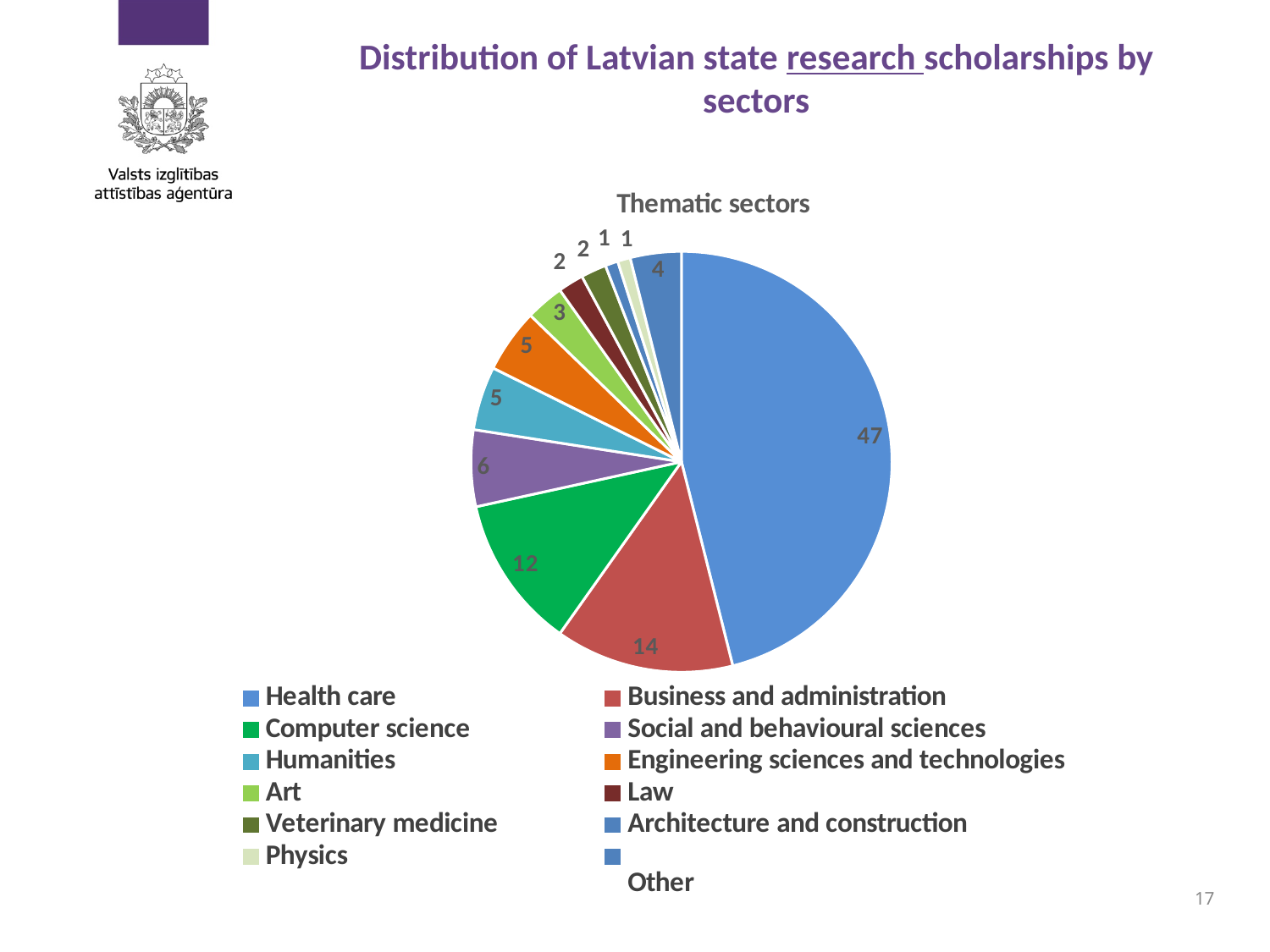
What colour is the Engineering sciences and technologies slice? Orange What is the title of the chart? Thematic sectors What is the value for Other? 4 What is the difference between the values for Health care and Business and administration? 33 Which sector has the largest slice? Health care What is the value for Health care? 47 What type of chart is shown on the slide? Pie chart What is the value for Computer science? 12 What is the value for Business and administration? 14 How many sectors are listed in the legend? 12 Which is larger, Computer science or Social and behavioural sciences? Computer science What is the value for Social and behavioural sciences? 6